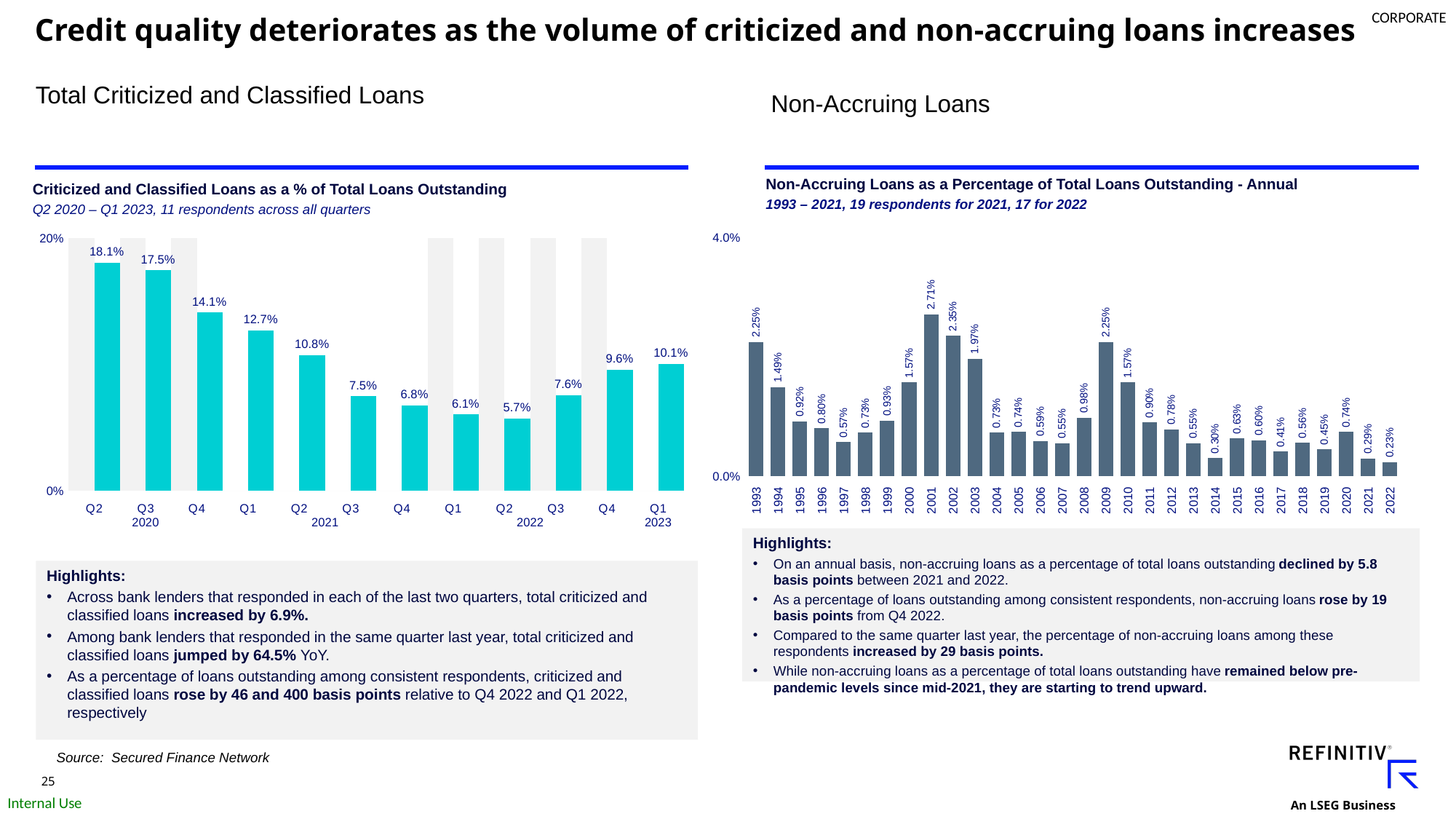
In the Criticized and Classified Loans chart, what is the value for Q2 2020? 18.1% What type of chart is the Non-Accruing Loans chart? bar chart In the Criticized and Classified Loans chart, which quarter has the lowest value? Q2 2022 In the Criticized and Classified Loans chart, do values rise or fall from Q2 2020 to Q2 2022? fall In the Non-Accruing Loans chart, which is larger, the value for 2009 or the value for 2010? 2009 In the Criticized and Classified Loans chart, what is the value for Q1 2023? 10.1% In the Criticized and Classified Loans chart, what is the difference between Q4 2022 and Q3 2022? 2.0% In the Criticized and Classified Loans chart, which quarter has the highest value? Q2 2020 In the Non-Accruing Loans chart, what is the value for 2001? 2.71% In the Non-Accruing Loans chart, which year has the lowest value? 2022 In the Criticized and Classified Loans chart, how many quarters are plotted? 12 In the Non-Accruing Loans chart, what is the value for 2022? 0.23%